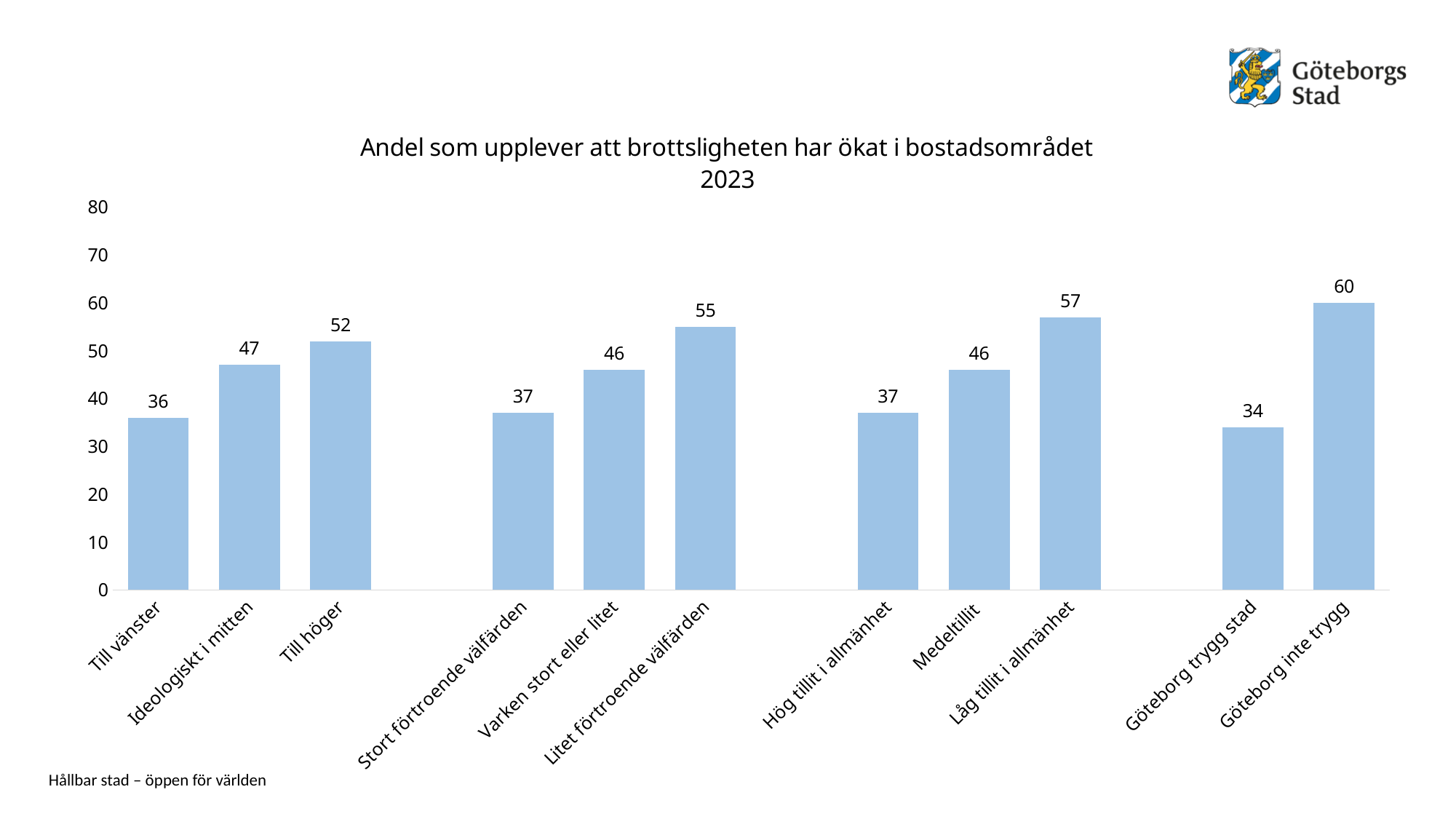
Which category has the highest value? Göteborg inte trygg What is the value for Till höger? 52 What is the value for Göteborg trygg stad? 34 What is the difference between Låg tillit i allmänhet and Hög tillit i allmänhet? 20 What is the difference between Göteborg inte trygg and Göteborg trygg stad? 26 What is the title of the chart? Andel som upplever att brottsligheten har ökat i bostadsområdet 2023 What kind of chart is this? bar chart Is the value for Medeltillit greater or less than 40? greater Which category has the lowest value? Göteborg trygg stad What is the value for Litet förtroende välfärden? 55 How many categories are shown on the x axis? 11 Which is larger, Till vänster or Ideologiskt i mitten? Ideologiskt i mitten